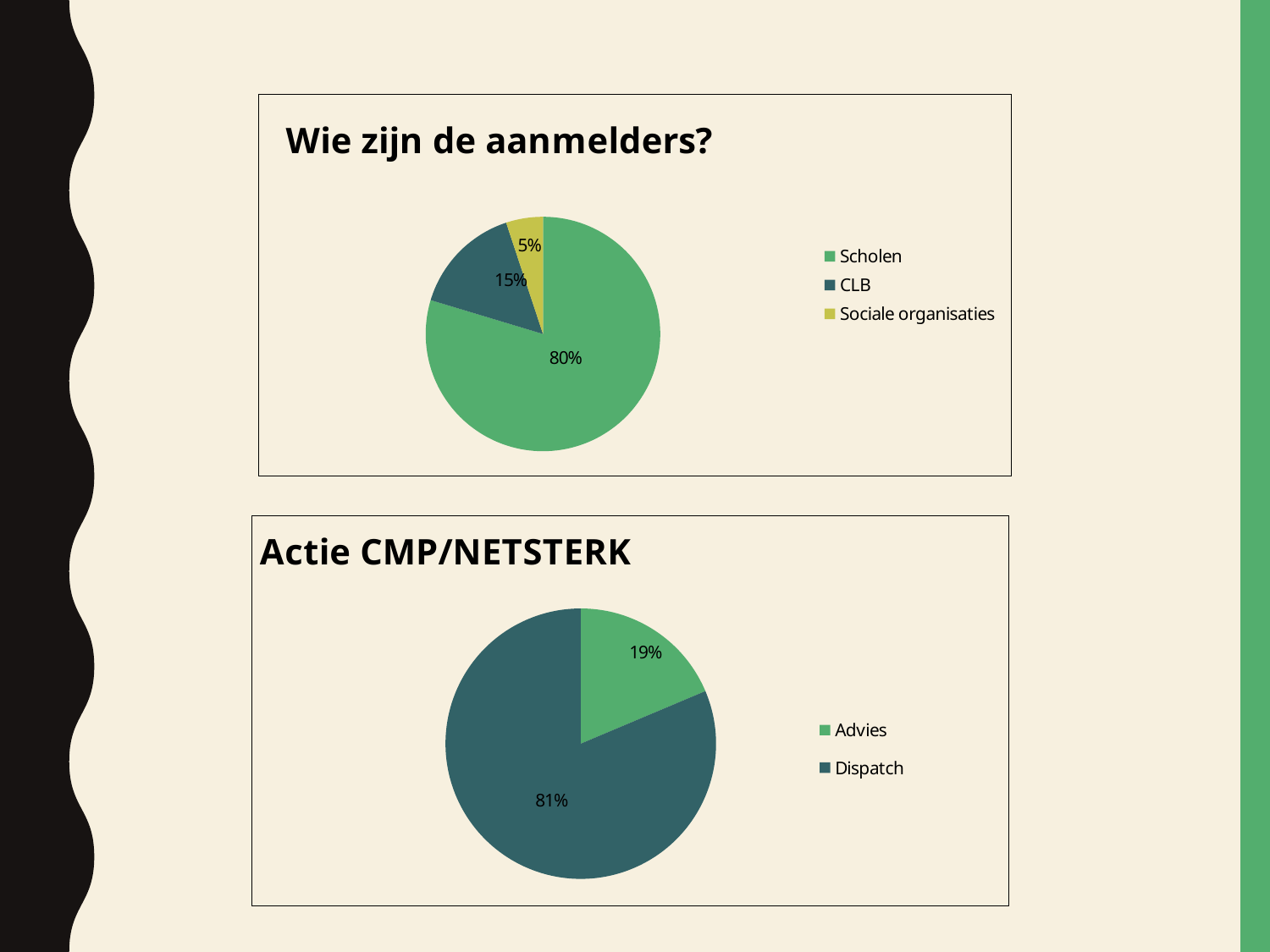
In the 'Wie zijn de aanmelders?' chart, what share of the pie is CLB? 15% In the 'Wie zijn de aanmelders?' chart, which category has the largest slice? Scholen In the 'Actie CMP/NETSTERK' chart, what is the difference in percentage points between Dispatch and Advies? 62 In the 'Wie zijn de aanmelders?' chart, how many categories does the legend list? 3 In the 'Wie zijn de aanmelders?' chart, what share of the pie is Scholen? 80% In the 'Wie zijn de aanmelders?' chart, what share of the pie is Sociale organisaties? 5% What kind of chart is the 'Actie CMP/NETSTERK' chart? Pie chart In the 'Wie zijn de aanmelders?' chart, what is the difference in percentage points between Scholen and CLB? 65 In the 'Actie CMP/NETSTERK' chart, what share of the pie is Dispatch? 81% In the 'Actie CMP/NETSTERK' chart, which is larger, Advies or Dispatch? Dispatch In the 'Wie zijn de aanmelders?' chart, which category has the smallest slice? Sociale organisaties In the 'Actie CMP/NETSTERK' chart, what share of the pie is Advies? 19%